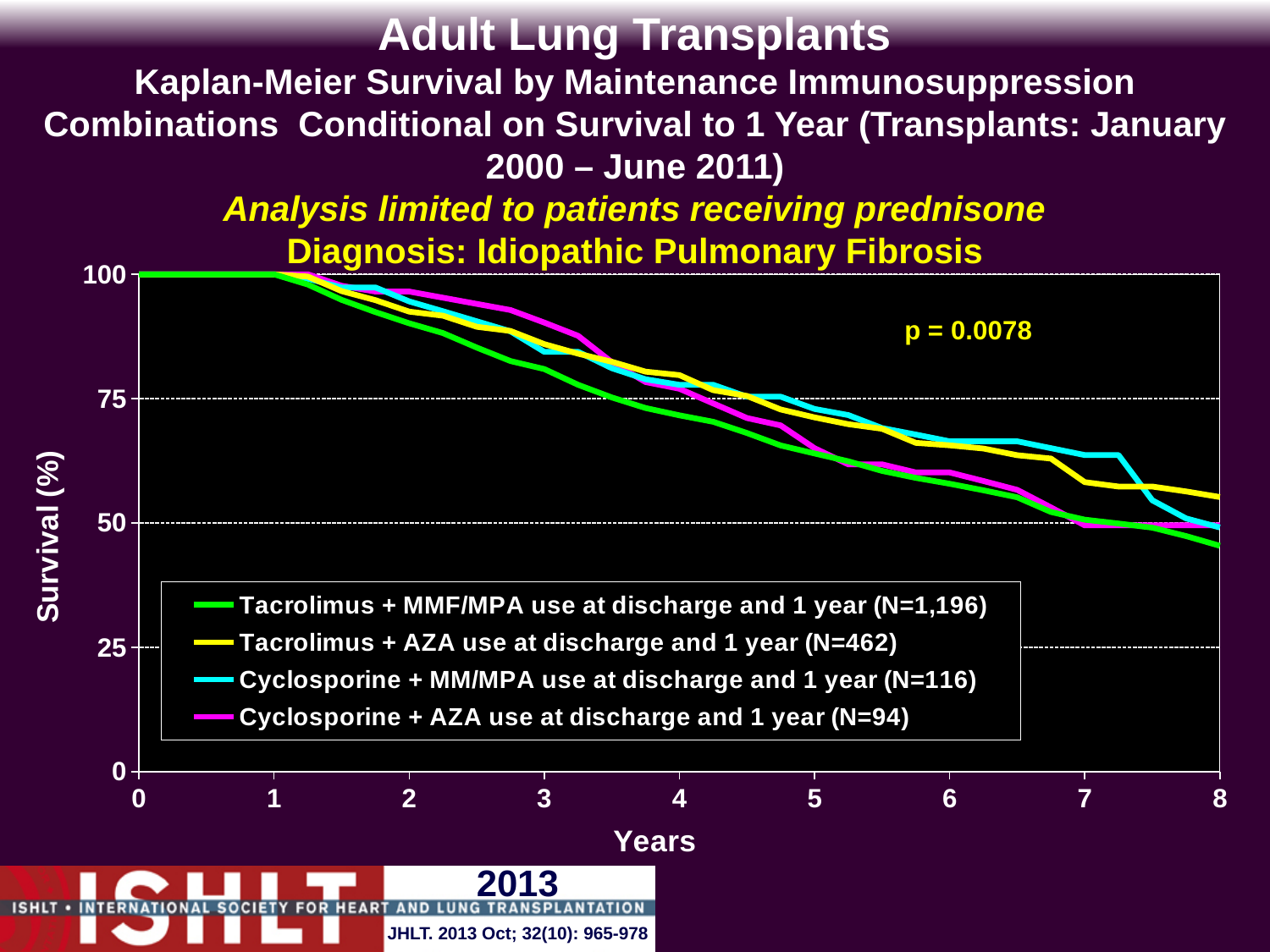
At year 8, which series has the highest survival? Tacrolimus + AZA use at discharge and 1 year (N=462) Do the survival curves rise or fall as years increase? fall At year 8, which series has the lowest survival? Tacrolimus + MMF/MPA use at discharge and 1 year (N=1,196) What is the survival value for Tacrolimus + MMF/MPA at year 1? 100 Is the survival value for Cyclosporine + AZA at year 3 greater or less than 75? greater What p-value is shown on the chart? p = 0.0078 At year 6, which is higher: Cyclosporine + MM/MPA or Tacrolimus + MMF/MPA? Cyclosporine + MM/MPA Is the survival value for Tacrolimus + MMF/MPA at year 8 greater or less than 50? less Is the survival value for Tacrolimus + AZA at year 8 greater or less than 50? greater How many series does the legend list? 4 What kind of chart is shown on the slide? line chart